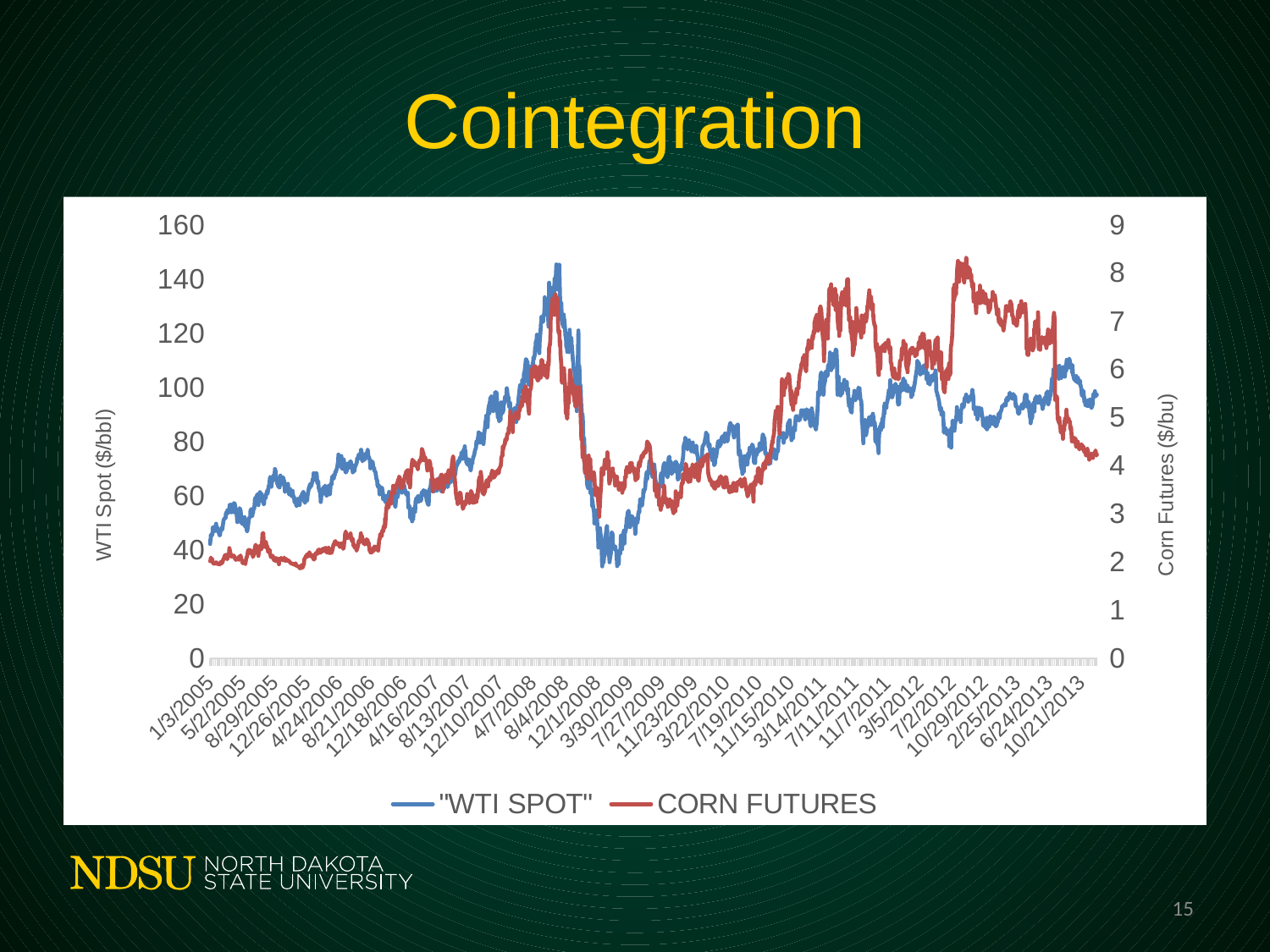
Is the peak value of the CORN FUTURES series in 2012 greater or less than 7? greater What kind of chart is shown on the slide? line chart What is the title of the chart on the slide? Cointegration What is the highest tick value shown on the right vertical axis? 9 Is the peak value of the WTI SPOT series in 2008 greater or less than 120? greater Is the lowest value of the WTI SPOT series in early 2009 greater or less than 40? less Which series is plotted in red? CORN FUTURES Does the CORN FUTURES series rise or fall between 7/2/2012 and 10/21/2013? fall What is the label of the right vertical axis? Corn Futures ($/bu) What is the highest tick value shown on the left vertical axis? 160 How many series does the legend list? 2 What is the label of the left vertical axis? WTI Spot ($/bbl)